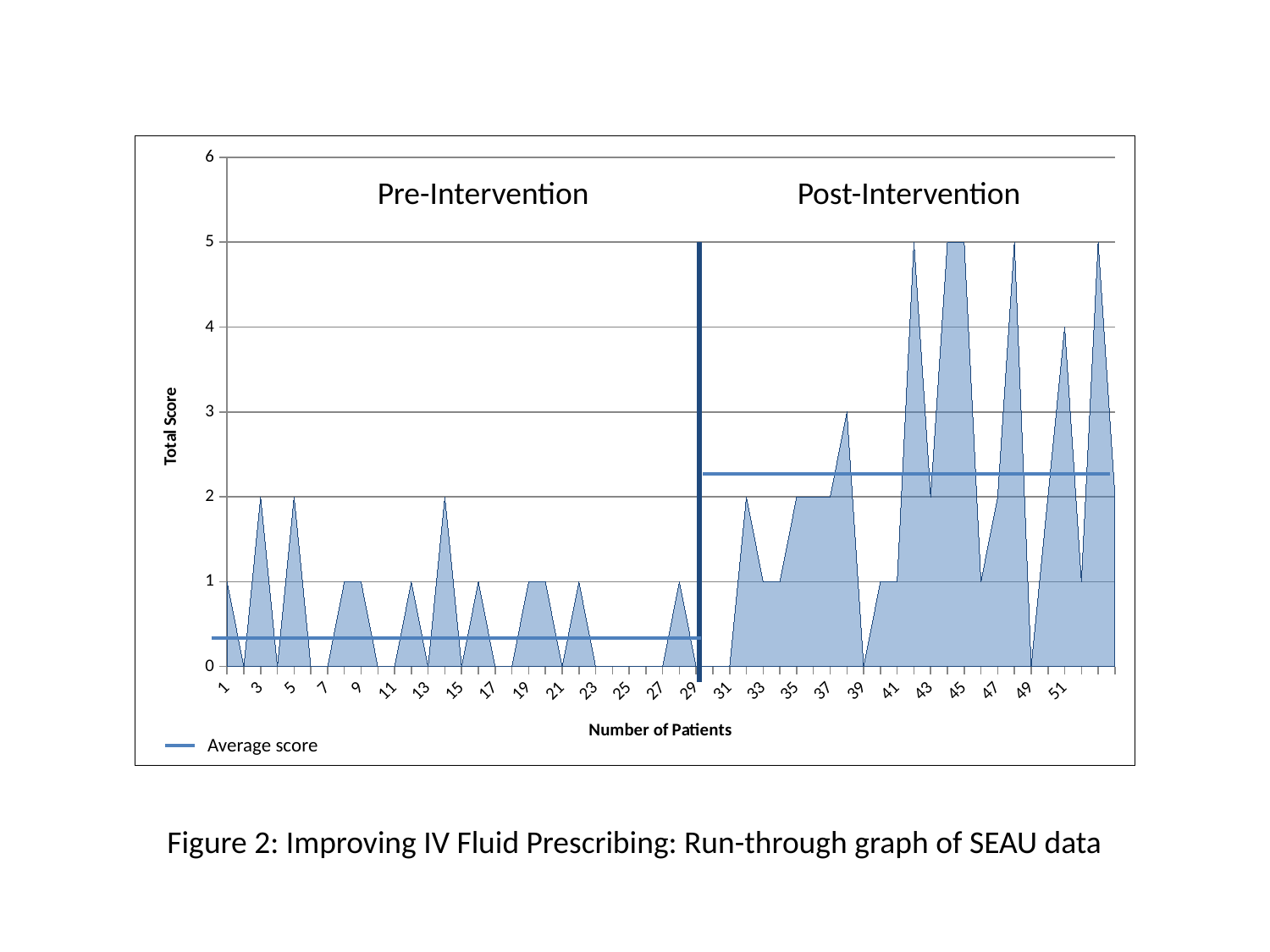
What is the maximum value shown on the y-axis? 6 How many entries does the legend list? 1 What is the title of the x-axis? Number of Patients Do the total scores generally rise or fall when moving from the Pre-Intervention section to the Post-Intervention section? Rise What type of chart is shown on the slide? Area chart What is the lowest total score shown on the chart? 0 What is the highest total score reached in the Post-Intervention section? 5 Is the Post-Intervention average score line greater or less than 2? greater Is the Pre-Intervention average score line greater or less than 1? less What is the highest total score reached in the Pre-Intervention section? 2 Which section has the higher average score line, Pre-Intervention or Post-Intervention? Post-Intervention What is the title of the y-axis? Total Score